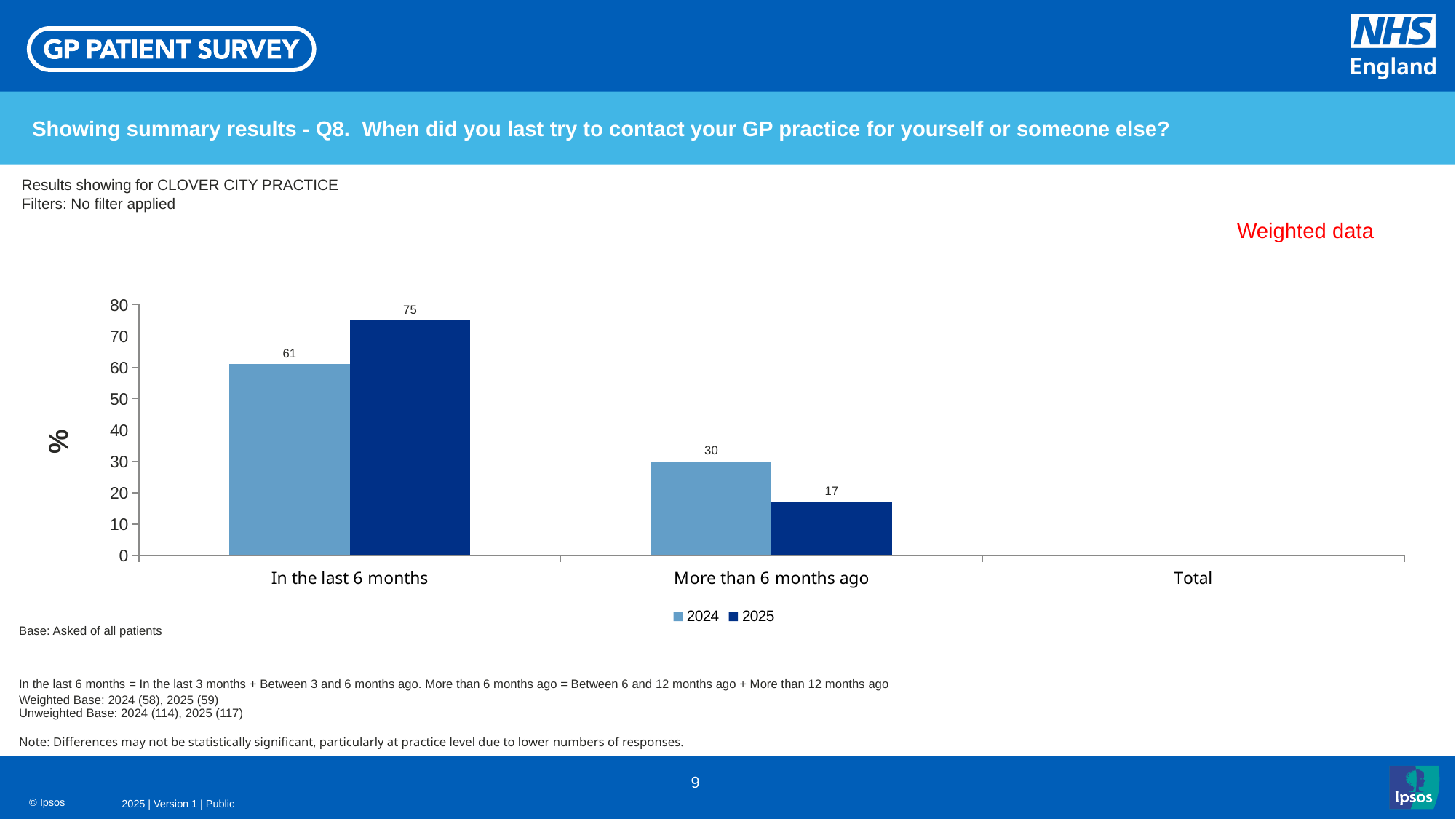
For 'More than 6 months ago', which year has the larger value, 2024 or 2025? 2024 What is the 2024 value for 'More than 6 months ago'? 30 What kind of chart is shown on the slide? Bar chart What is the 2025 value for 'In the last 6 months'? 75 Which category has the lowest 2024 value? More than 6 months ago How many series does the legend list? 2 What is the difference between the 2025 and 2024 values for 'In the last 6 months'? 14 What label is shown on the vertical axis? % What is the 2024 value for 'In the last 6 months'? 61 What is the 2025 value for 'More than 6 months ago'? 17 What is the difference between the 2024 and 2025 values for 'More than 6 months ago'? 13 Which category has the highest 2025 value? In the last 6 months